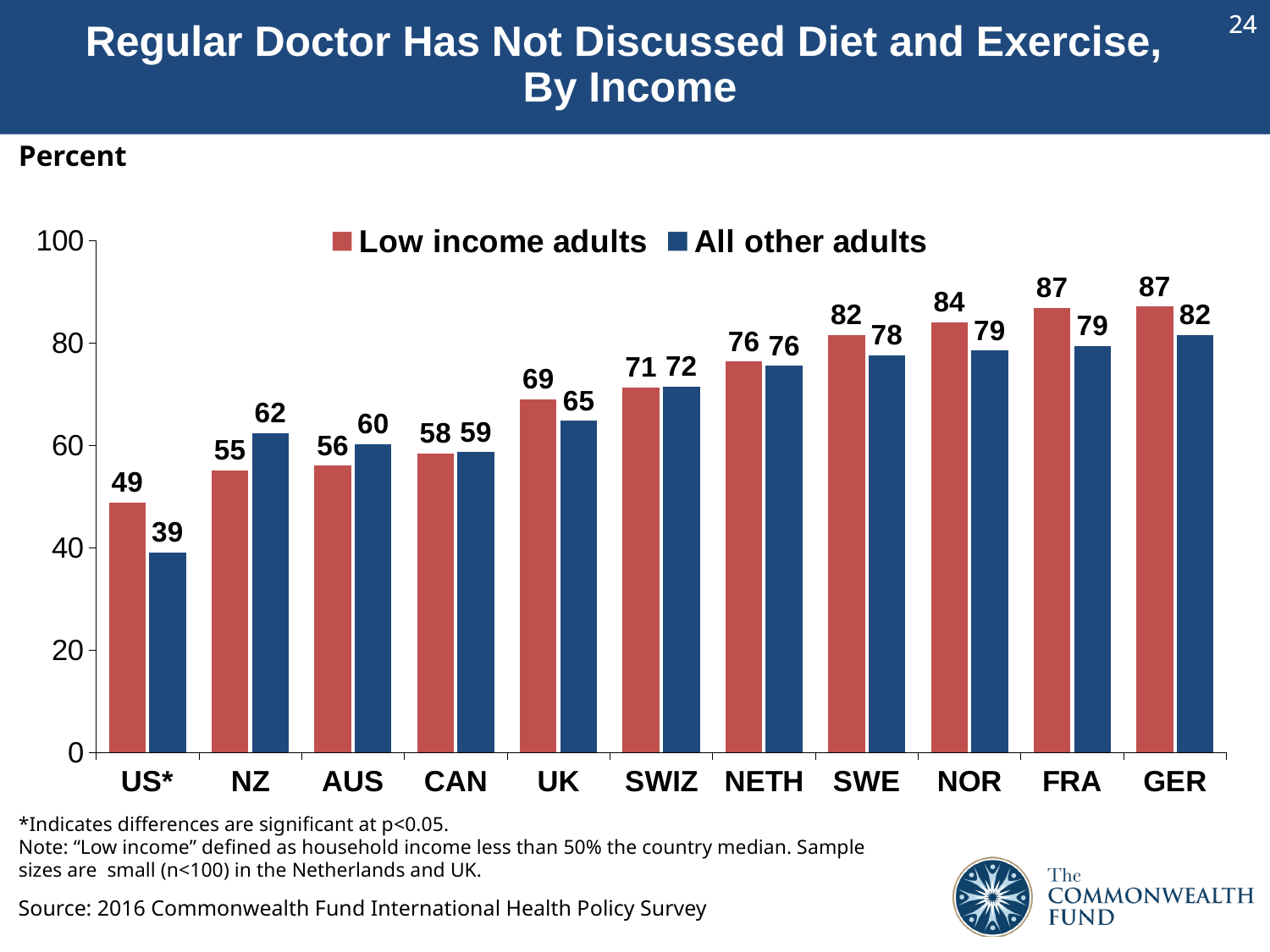
Which country has the lowest value for All other adults? US* What is the difference between the Low income adults values for FRA and NZ? 32 How many countries are shown on the x axis? 11 Which country has the highest value for All other adults? GER What is the difference between Low income adults and All other adults in the US*? 10 Which is larger in NOR: the value for Low income adults or for All other adults? Low income adults Which series is shown in red? Low income adults How many series does the legend list? 2 What is the value for All other adults in GER? 82 What is the value for Low income adults in the US*? 49 What kind of chart is shown on the slide? Bar chart What is the value for All other adults in NZ? 62